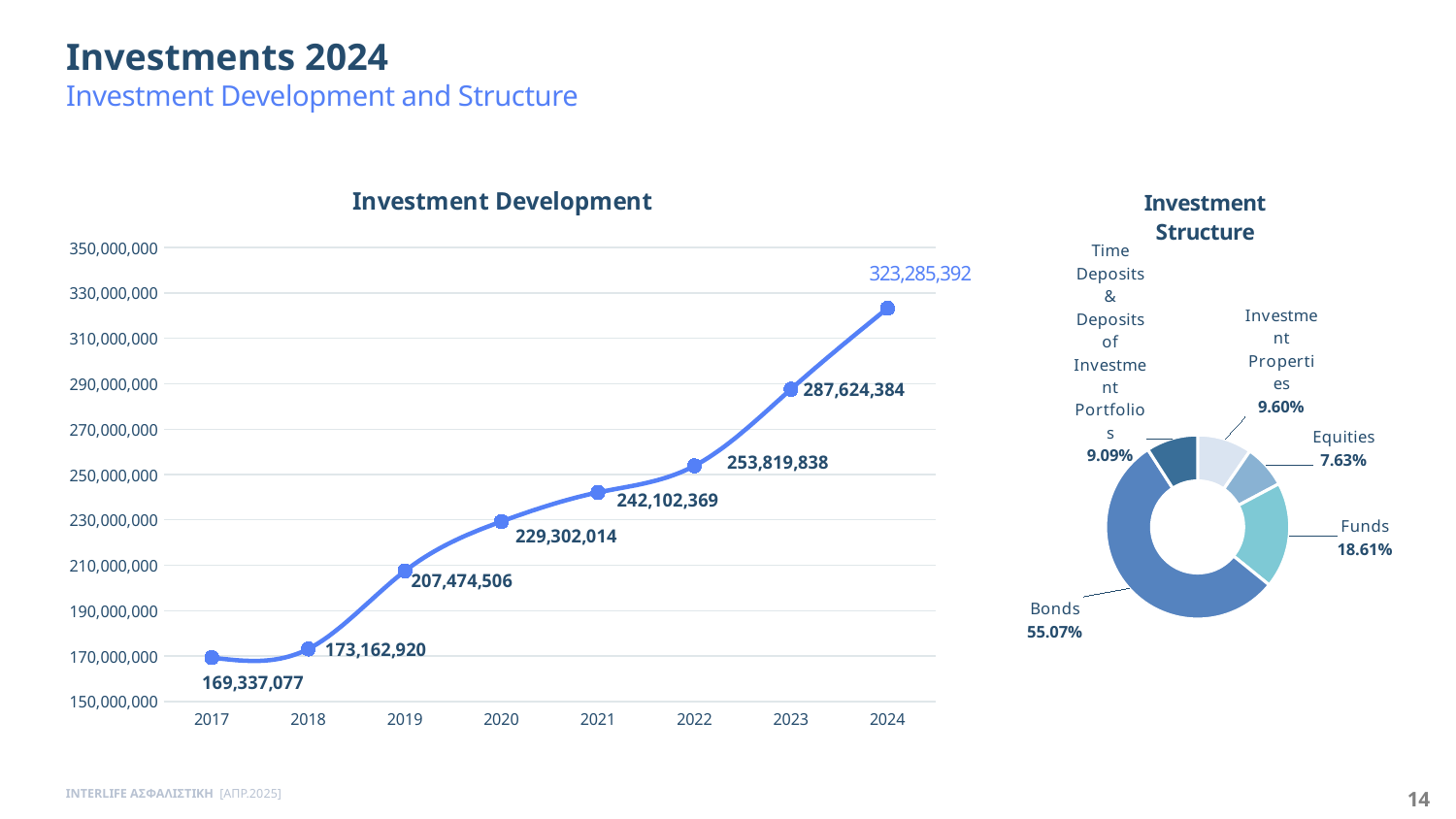
What kind of chart is the Investment Development chart? line chart In the Investment Structure chart, which is larger, Funds or Investment Properties? Funds In the Investment Structure chart, which category has the smallest share? Equities In the Investment Development chart, do the values rise or fall from 2017 to 2024? rise In the Investment Development chart, what is the difference between the 2024 and 2023 values? 35,661,008 In the Investment Development chart, which year has the lowest value? 2017 In the Investment Development chart, what is the value for 2024? 323,285,392 In the Investment Development chart, what is the difference between the 2018 and 2017 values? 3,825,843 In the Investment Development chart, how many years are plotted? 8 In the Investment Development chart, what is the value for 2020? 229,302,014 In the Investment Structure chart, what share do Bonds have? 55.07% In the Investment Development chart, which year has the highest value? 2024